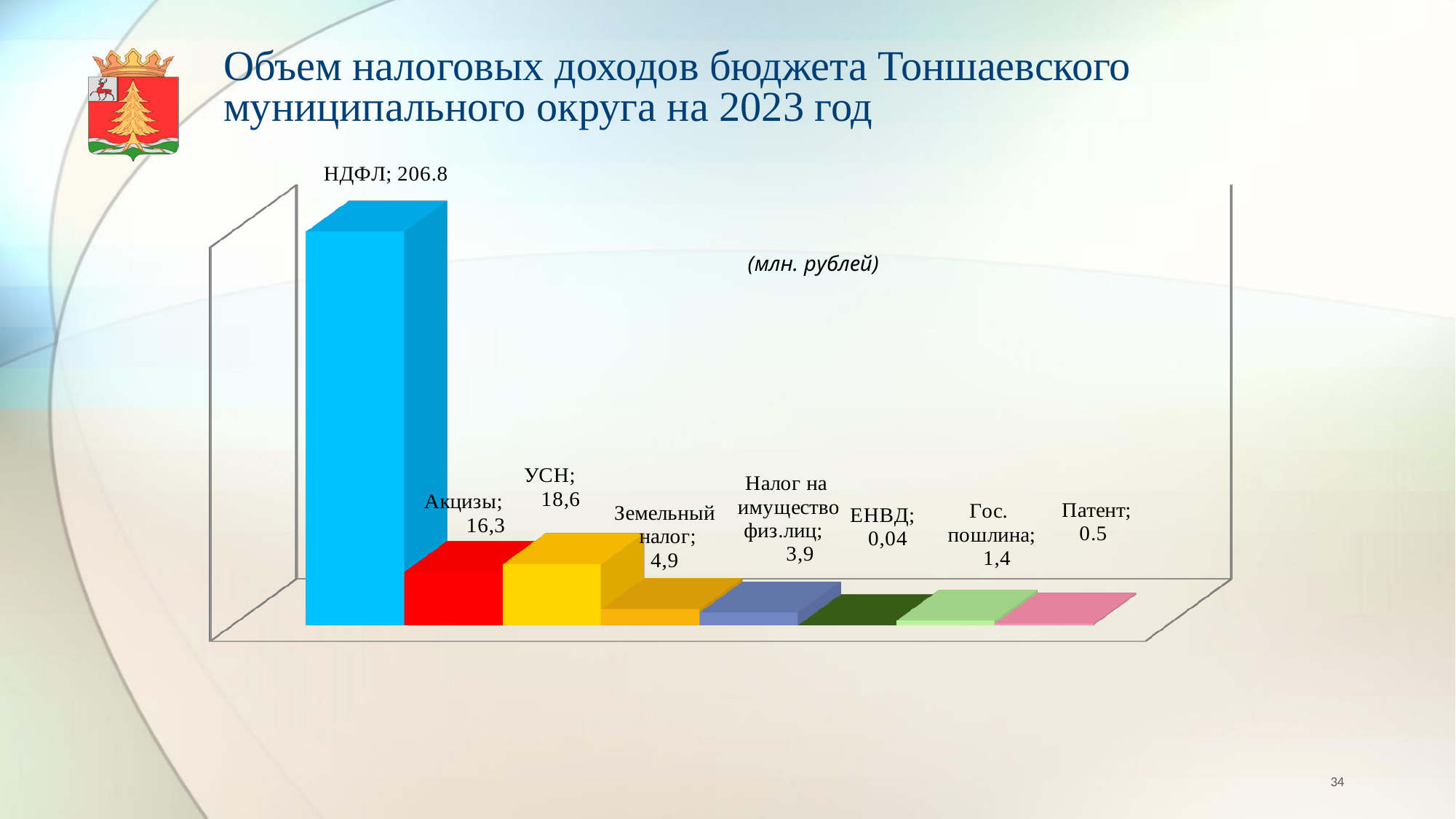
What is the value for ЕНВД? 0,04 What type of chart is shown on the slide? bar chart What is the value for УСН? 18,6 How many categories are shown in the chart? 8 What is the value for НДФЛ? 206.8 What is the value for Акцизы? 16,3 What is the value for Гос. пошлина? 1,4 What is the difference between the values for УСН and Акцизы? 2,3 Which category has the highest value? НДФЛ Which is larger, Акцизы or УСН? УСН In what units are the chart values given, according to the label on the chart? млн. рублей Which category has the lowest value? ЕНВД